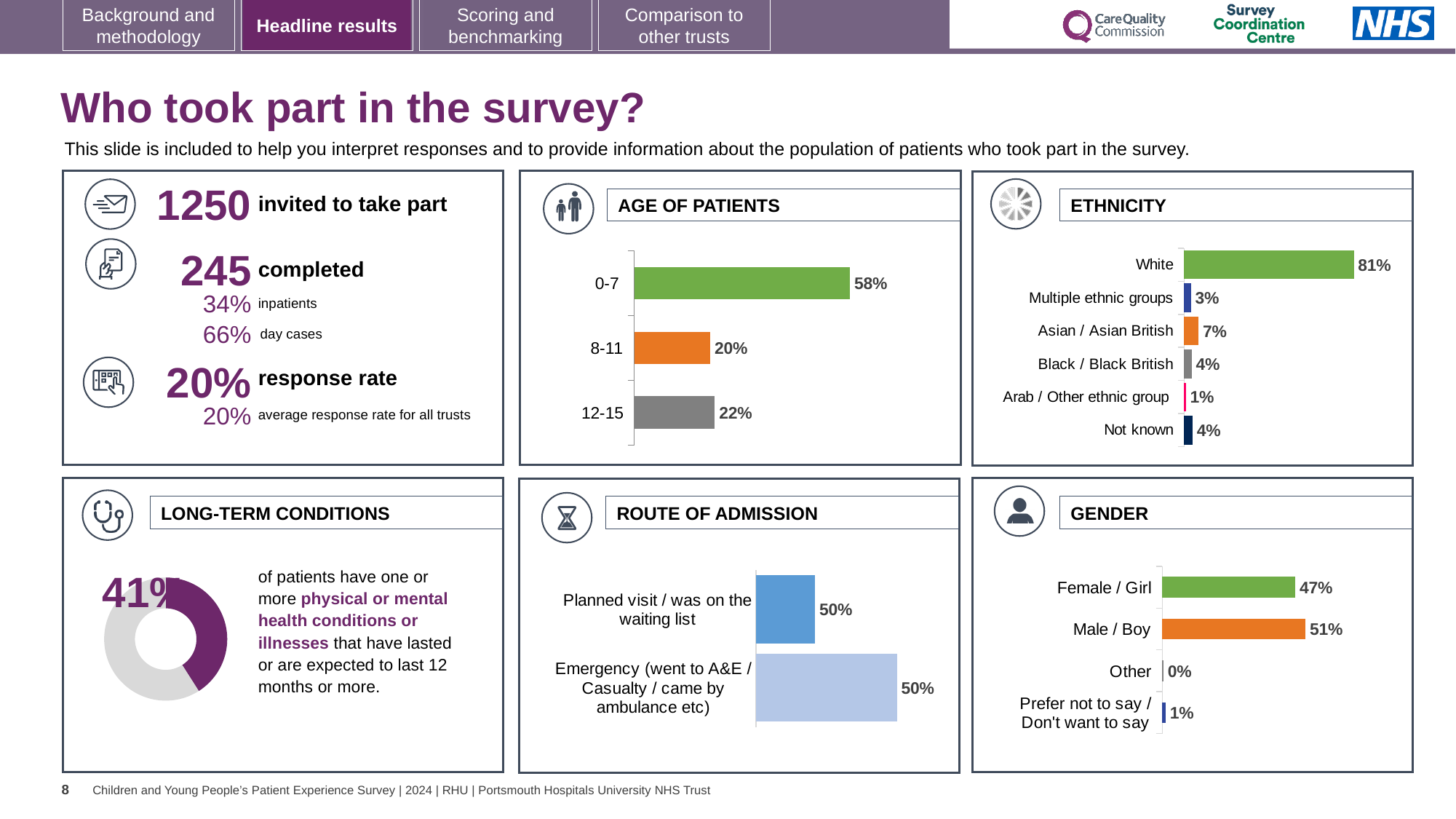
What kind of chart is used in the LONG-TERM CONDITIONS panel? Donut chart In the AGE OF PATIENTS chart, what is the difference between the 0-7 and 12-15 percentages? 36% In the GENDER chart, what percentage of patients were Male / Boy? 51% In the ETHNICITY chart, which is larger: Multiple ethnic groups or Black / Black British? Black / Black British In the AGE OF PATIENTS chart, what percentage of patients were aged 0-7? 58% In the ETHNICITY chart, what percentage of patients were Asian / Asian British? 7% In the GENDER chart, what is the difference between Male / Boy and Female / Girl? 4% In the LONG-TERM CONDITIONS chart, what share of patients have one or more long-term conditions? 41% In the AGE OF PATIENTS chart, which age group has the lowest percentage? 8-11 In the ETHNICITY chart, which category has the highest percentage? White In the ROUTE OF ADMISSION chart, what percentage of patients had a planned visit / were on the waiting list? 50% How many categories are shown in the ETHNICITY chart? 6